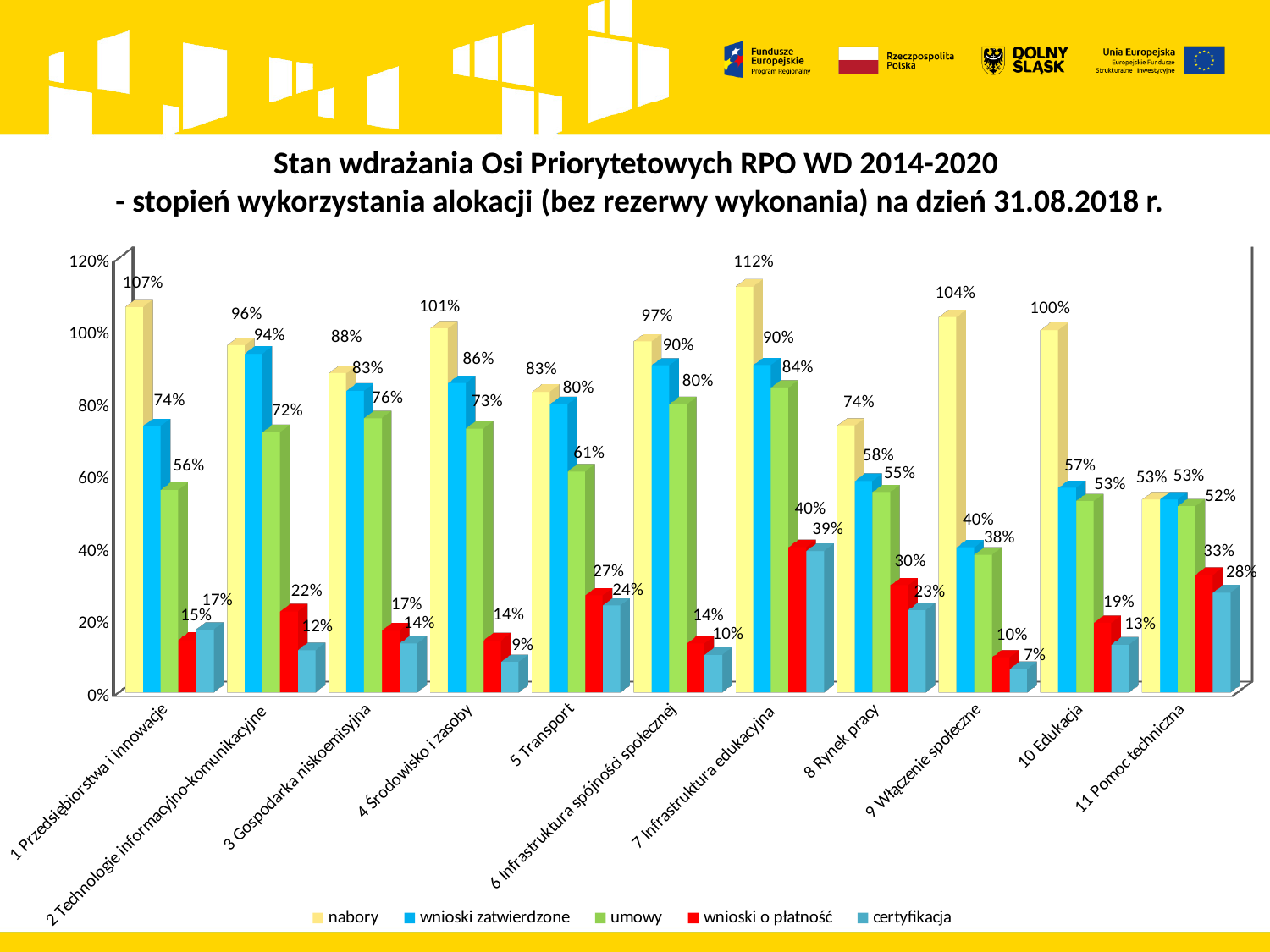
What is the value of nabory for 7 Infrastruktura edukacyjna? 112% What is the value of certyfikacja for 5 Transport? 24% Which category has the highest nabory value? 7 Infrastruktura edukacyjna Which category has the lowest certyfikacja value? 9 Włączenie społeczne How many series does the legend list? 5 What is the value of wnioski zatwierdzone for 2 Technologie informacyjno-komunikacyjne? 94% Which is larger for 4 Środowisko i zasoby: wnioski zatwierdzone or umowy? wnioski zatwierdzone What kind of chart is shown on the slide? bar chart How many categories are shown on the x axis? 11 Which series is shown in red in the legend? wnioski o płatność What is the value of wnioski o płatność for 8 Rynek pracy? 30% What is the difference between nabory and umowy for 1 Przedsiębiorstwa i innowacje? 51%